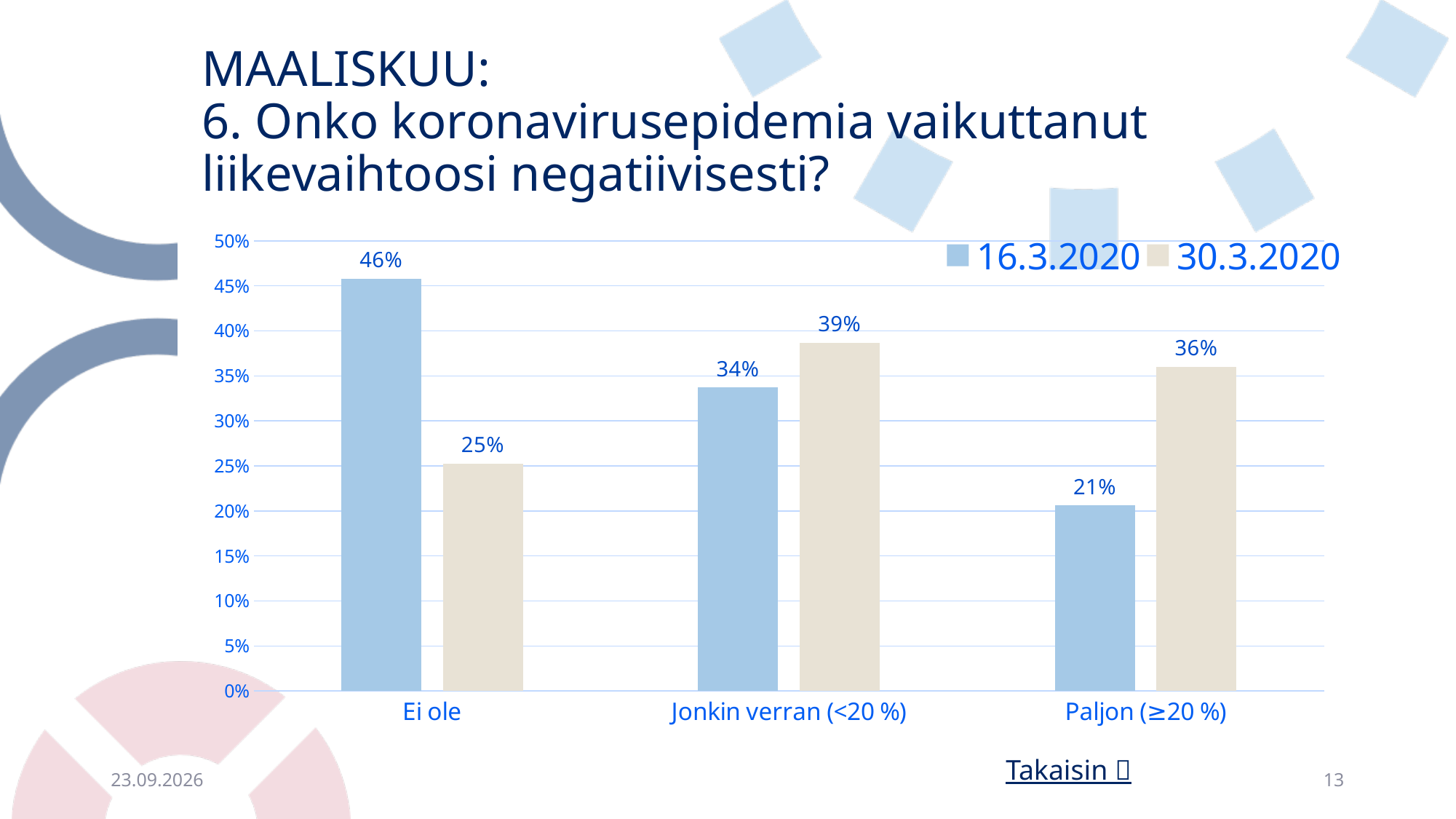
Is the 30.3.2020 value for "Ei ole" greater or less than 30%? less What kind of chart is shown on the slide? bar chart What is the value for "Ei ole" in the 16.3.2020 series? 46% For "Paljon (≥20 %)", which series has the larger value, 16.3.2020 or 30.3.2020? 30.3.2020 What is the value for "Paljon (≥20 %)" in the 30.3.2020 series? 36% What is the difference between the 16.3.2020 and 30.3.2020 values for "Ei ole"? 21% How many series does the legend list? 2 Which category has the highest value in the 30.3.2020 series? Jonkin verran (<20 %) How many categories are shown on the x axis? 3 Which category has the lowest value in the 16.3.2020 series? Paljon (≥20 %) What is the value for "Jonkin verran (<20 %)" in the 16.3.2020 series? 34% What are the two series names in the legend? 16.3.2020 and 30.3.2020